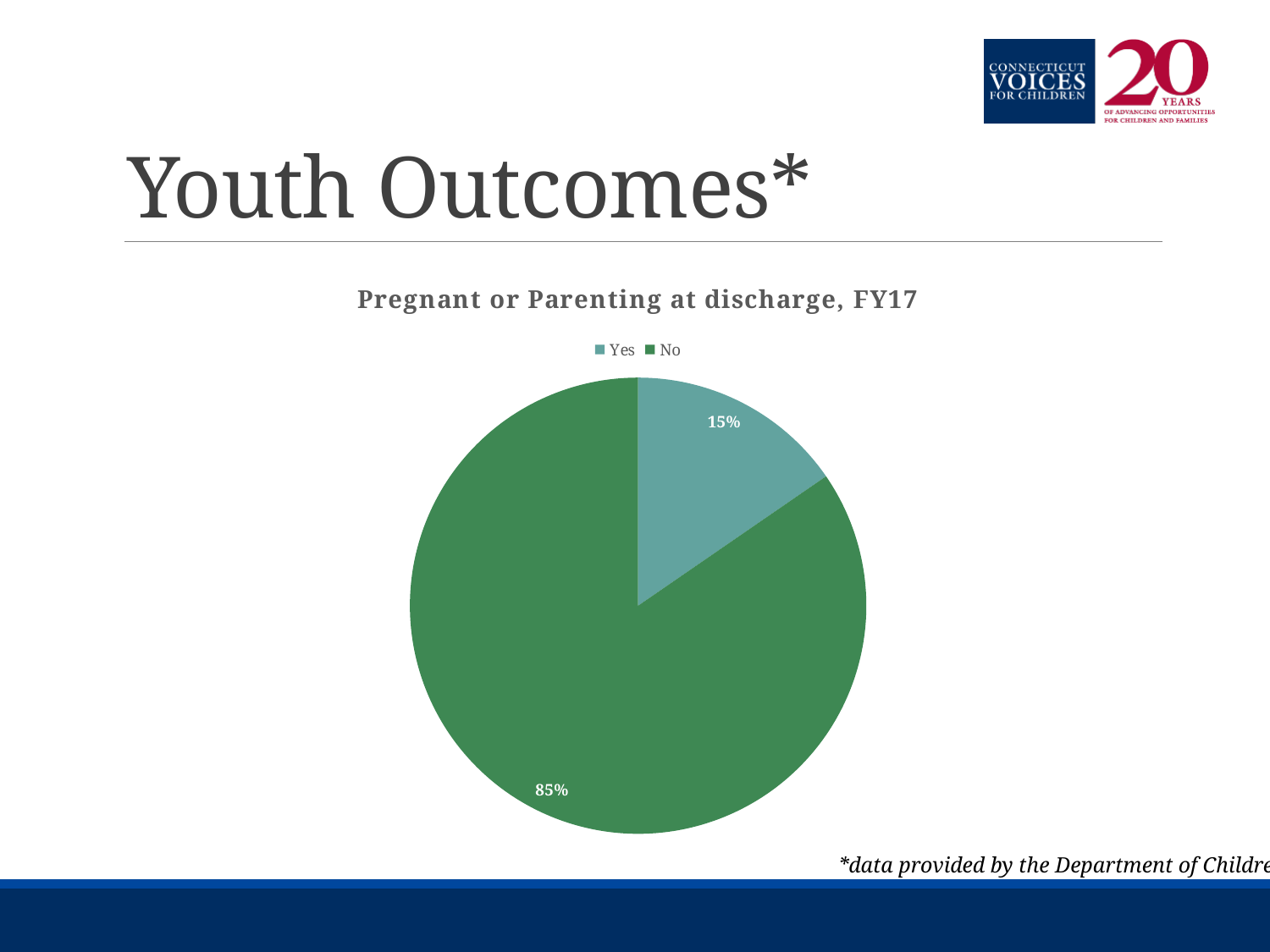
What percentage of youth were not pregnant or parenting at discharge (No)? 85% How many slices does the pie chart have? 2 Which category has the largest share of the pie? No What type of chart is shown on the slide? pie chart What is the difference between the No share and the Yes share? 70% Which legend entry is shown in the darker green colour? No Which is larger, the Yes share or the No share? No How many categories does the legend list? 2 What is the title of the chart? Pregnant or Parenting at discharge, FY17 What share of the pie does the Yes slice represent? 15% Which category has the smallest share of the pie? Yes What percentage of youth were pregnant or parenting at discharge (Yes)? 15%